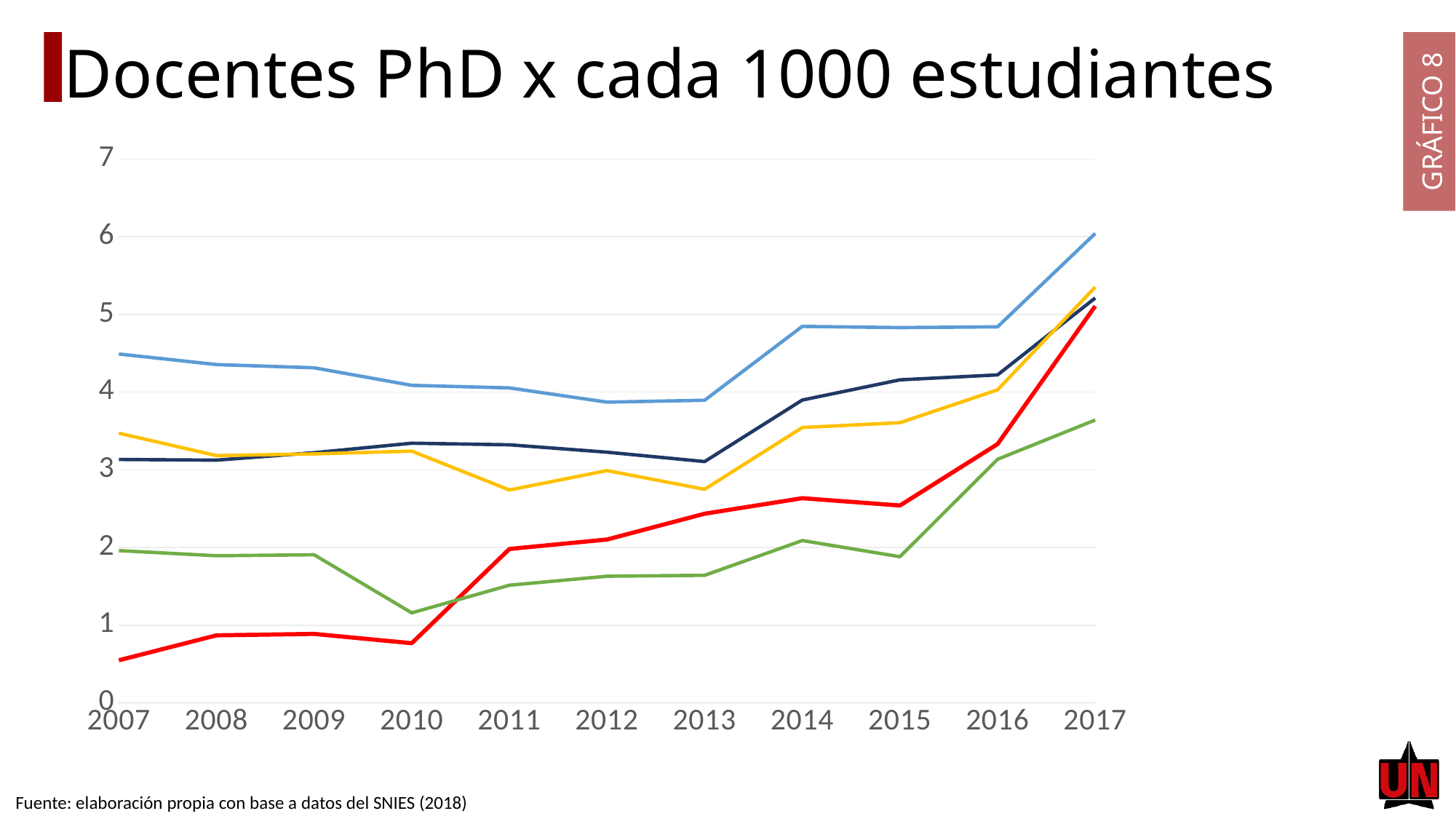
How many lines are plotted on the chart? 5 Is the value of the yellow line in 2011 greater or less than 3? less What is the title of the chart? Docentes PhD x cada 1000 estudiantes Is the value of the light blue line in 2014 greater or less than 4? greater Which line has the lowest value in 2007? The red line Is the value of the green line in 2010 greater or less than 2? less How many years are shown on the x axis of the chart? 11 Which line has the highest value in 2017? The light blue line What kind of chart is shown on the slide? Line chart In 2010, which is higher: the green line or the red line? The green line